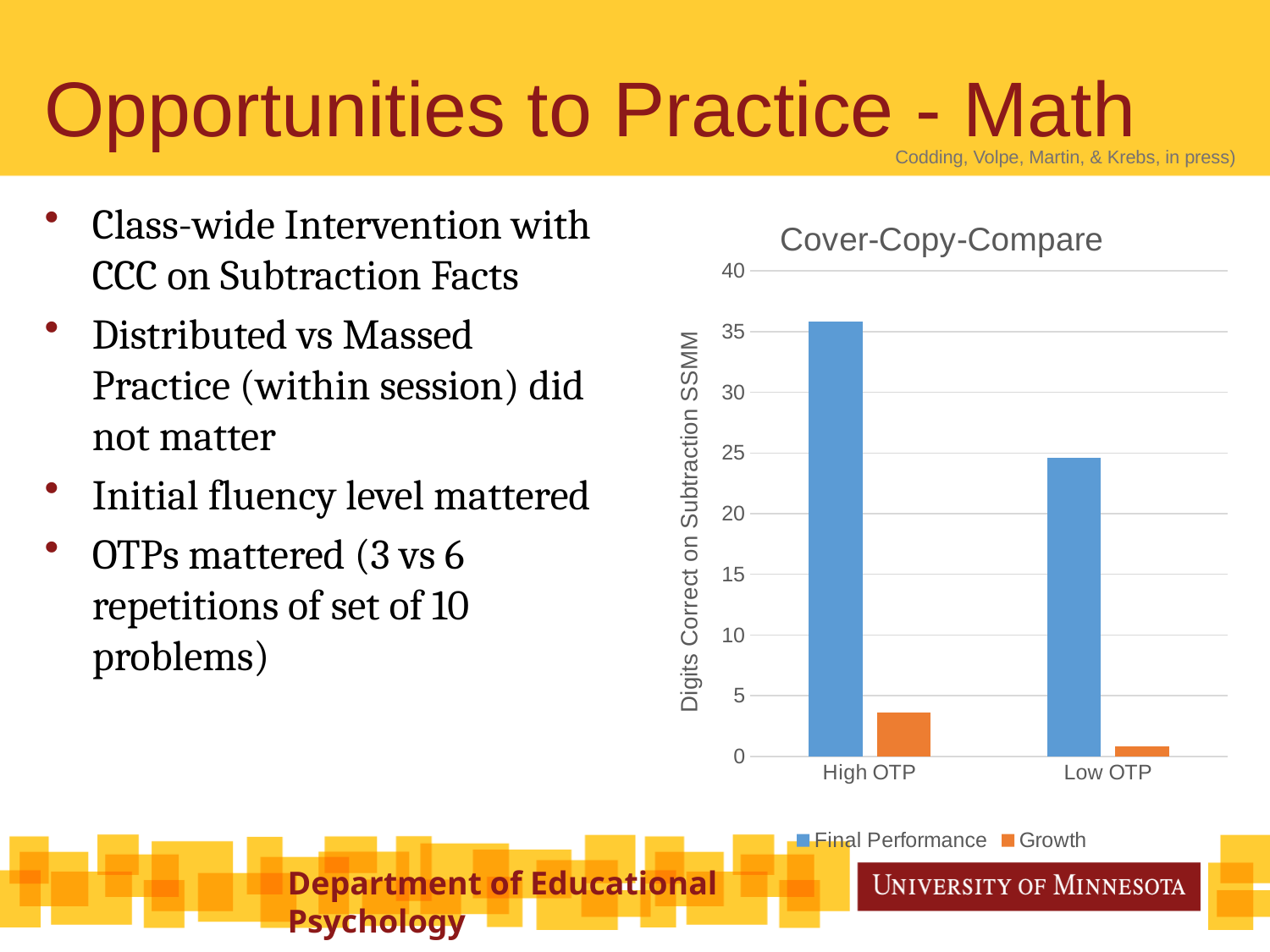
Which category has the lowest Growth value? Low OTP Which category has the highest Final Performance value? High OTP Is the Final Performance value for Low OTP greater or less than 30? less Is the Final Performance value for High OTP greater or less than 30? greater How many series does the chart legend list? 2 What is the title of the chart? Cover-Copy-Compare Is the Growth value for Low OTP greater or less than 5? less What is the label of the vertical axis of the chart? Digits Correct on Subtraction SSMM Which category has the higher Final Performance, High OTP or Low OTP? High OTP What kind of chart is shown on the slide? bar chart How many categories are shown on the x axis of the chart? 2